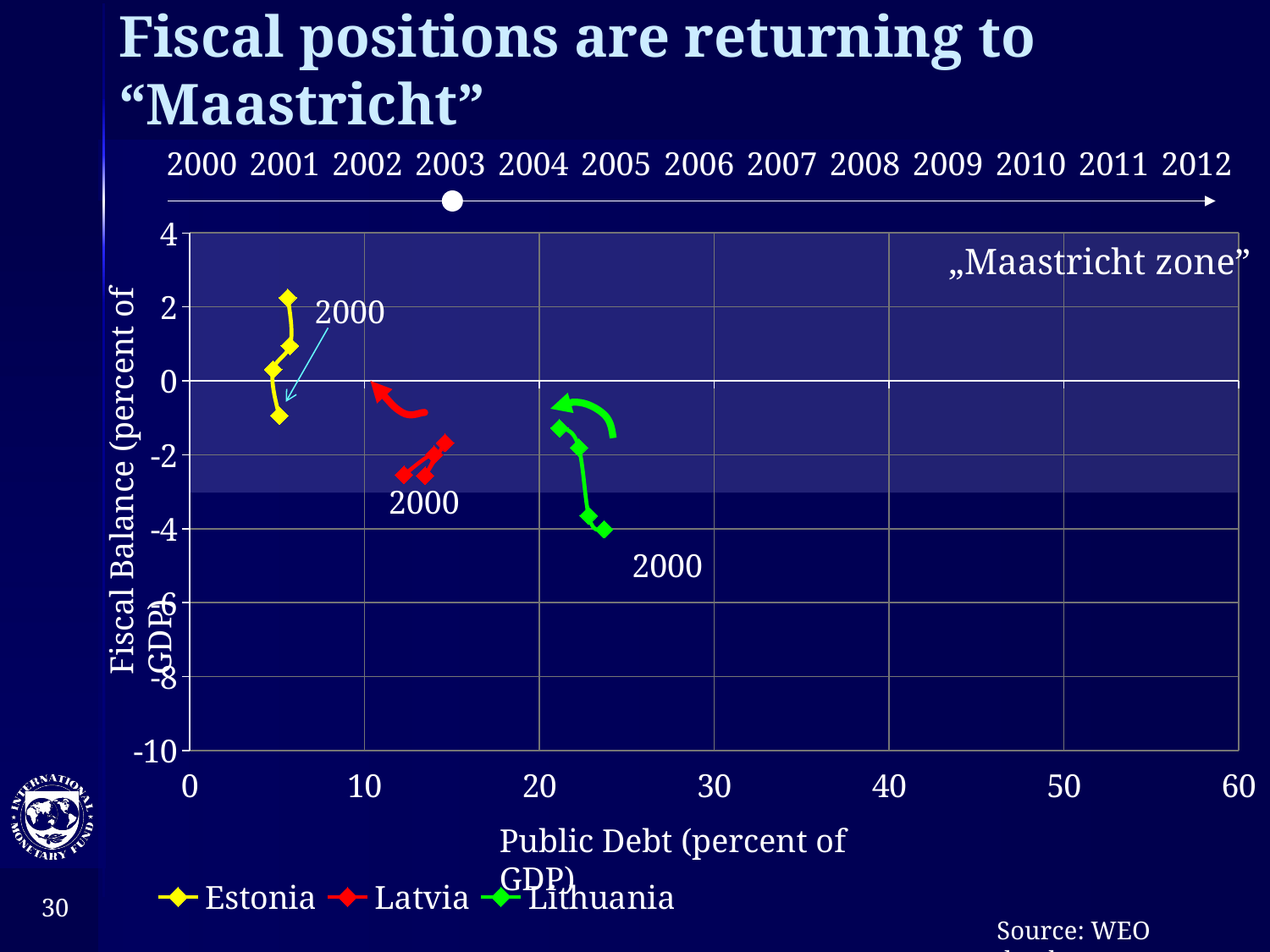
Is the fiscal balance of Lithuania's 2000 point greater or less than -2? less Which country's points have the lowest public debt? Estonia Which countries are listed in the legend? Estonia, Latvia, Lithuania What is the label of the x axis? Public Debt (percent of GDP) Which country's points lie furthest to the right, i.e. have the highest public debt? Lithuania Which country reaches the highest fiscal balance on the chart? Estonia How many countries does the legend list? 3 Is the public debt of Estonia's points greater or less than 10? less What kind of chart is shown on the slide? scatter chart Which country has the lowest fiscal balance point on the chart? Lithuania Is the fiscal balance of Latvia's 2000 point greater or less than 0? less